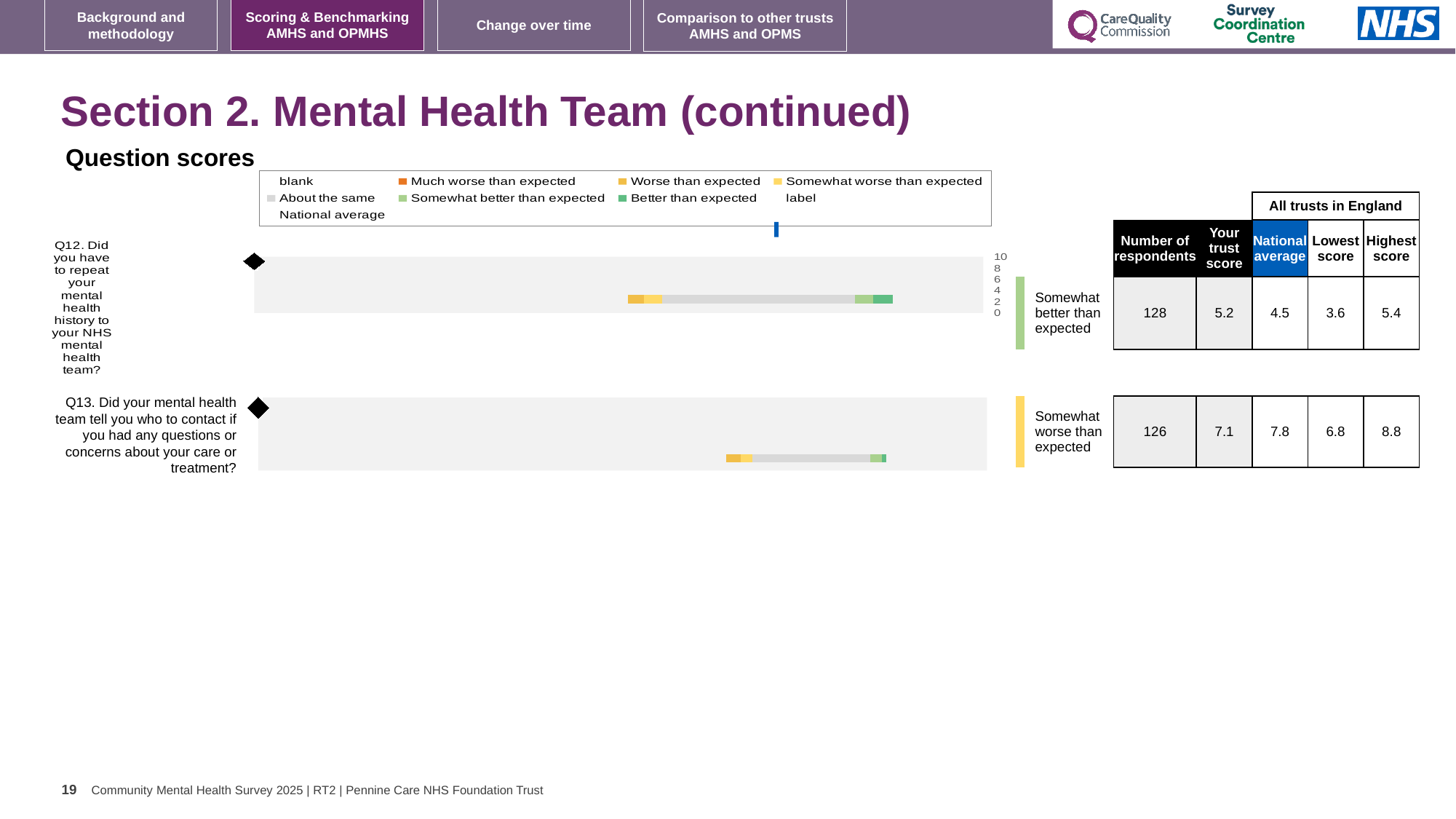
For Q13, which is larger: the trust's score or the national average? the national average For Q12 (repeating mental health history), what is the national average score? 4.5 For Q12, which is larger: the trust's score or the national average? the trust's score How is the trust's result for Q12 categorised on the slide? Somewhat better than expected For Q13, what is the difference between the highest score and the lowest score across all trusts in England? 2.0 For Q13 (who to contact with questions or concerns), how many respondents were there? 126 How is the trust's result for Q13 categorised on the slide? Somewhat worse than expected For Q12, what is the highest score across all trusts in England? 5.4 What kind of chart is used to show the question scores for Q12 and Q13? bar chart How many questions are plotted on the slide? 2 For Q13 (who to contact with questions or concerns), what is the trust's score? 7.1 For Q12 (repeating mental health history), what is the trust's score? 5.2